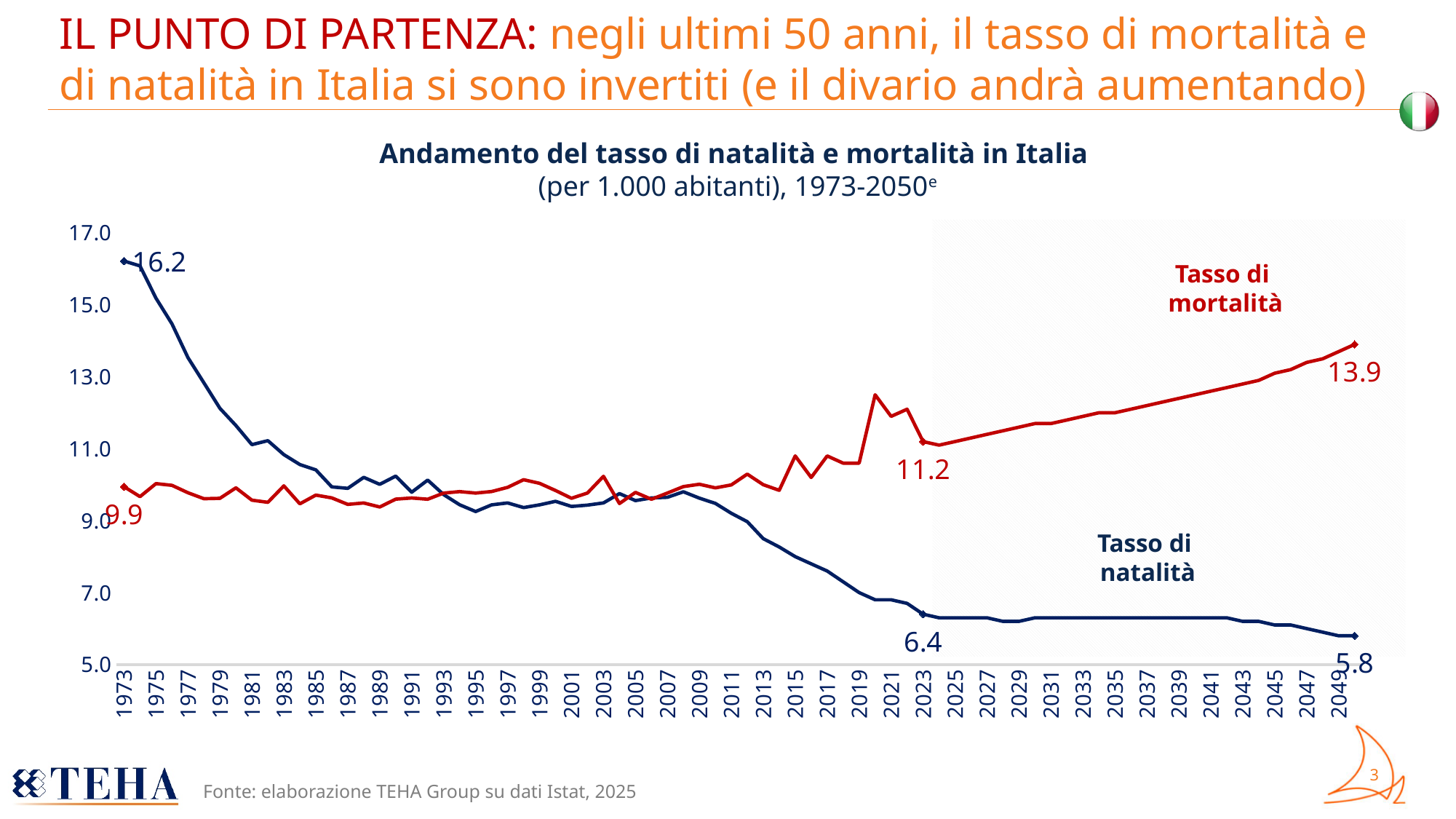
What is the difference between the death rate and the birth rate in 2023? 4.8 Does the birth rate (tasso di natalità) rise or fall from 1973 to 2050? fall How many series are plotted on the chart? 2 What is the birth rate (tasso di natalità) in Italy in 1973? 16.2 What is the death rate (tasso di mortalità) in Italy in 1973? 9.9 Which is larger in 2050: the death rate or the birth rate? death rate (tasso di mortalità) What is the birth rate (tasso di natalità) in 2023? 6.4 What is the projected death rate (tasso di mortalità) at the end of the series in 2050? 13.9 What is the projected birth rate (tasso di natalità) at the end of the series in 2050? 5.8 What is the death rate (tasso di mortalità) in 2023? 11.2 What kind of chart is shown on the slide? line chart What is the difference between the birth rate and the death rate in 1973? 6.3